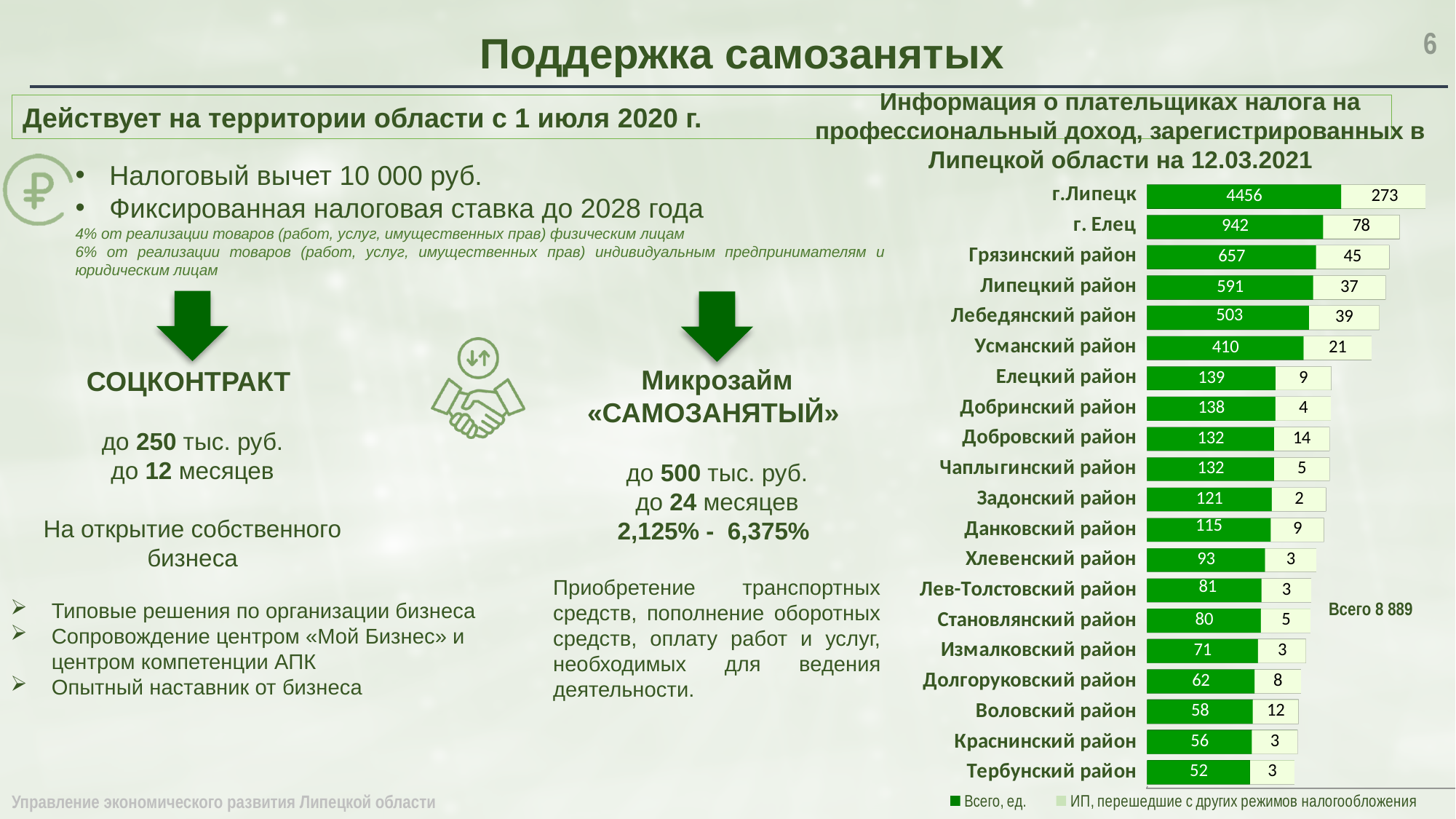
How many categories (districts/cities) are shown in the chart? 20 What overall total is printed next to the chart? Всего 8 889 What is the value of 'ИП, перешедшие с других режимов налогообложения' for г. Елец? 78 Which has a larger 'Всего, ед.' value: Лебедянский район or Усманский район? Лебедянский район What is the value of 'Всего, ед.' for Усманский район? 410 How many series does the legend of the chart list? 2 What type of chart is shown on the right side of the slide? bar chart Which category has the highest value of 'Всего, ед.'? г.Липецк What is the difference between the 'Всего, ед.' values for Грязинский район and Липецкий район? 66 Which category has the lowest value of 'Всего, ед.'? Тербунский район What is the value of 'Всего, ед.' for г.Липецк? 4456 What is the total of the stacked bar for Воловский район? 70